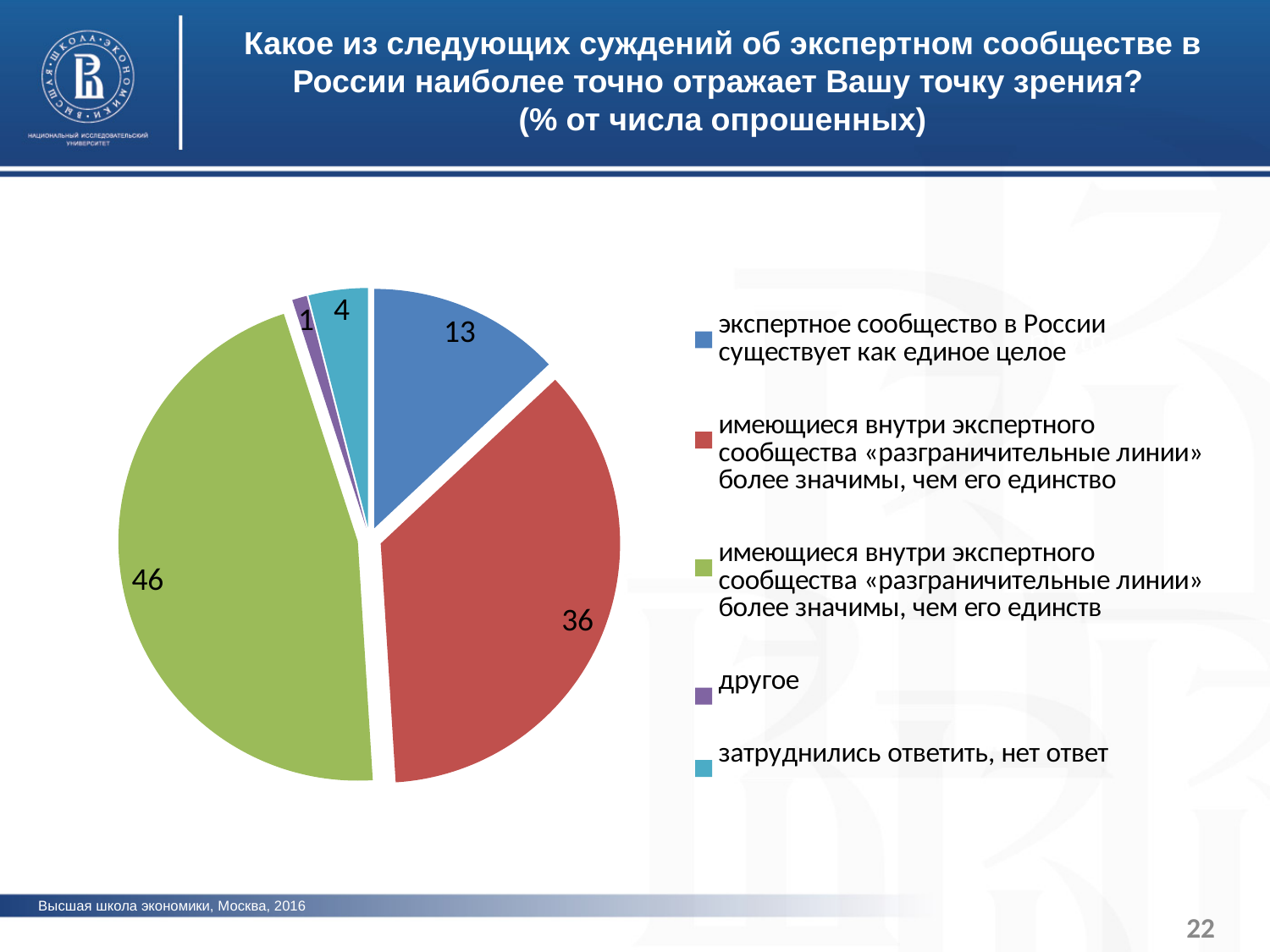
What is the difference between the value for 'экспертное сообщество в России существует как единое целое' and the value for 'затруднились ответить, нет ответ'? 9 What value is shown for the slice 'другое'? 1 What value is shown for the slice 'затруднились ответить, нет ответ'? 4 What value is shown for the slice 'экспертное сообщество в России существует как единое целое'? 13 How many slices does the pie chart have? 5 How many entries does the legend of the pie chart list? 5 Which is larger: the slice for 'экспертное сообщество в России существует как единое целое' or the slice for 'затруднились ответить, нет ответ'? экспертное сообщество в России существует как единое целое What colour is the slice for 'другое' in the pie chart? purple What is the difference between the value of the green slice and the value of the red slice? 10 Which legend category has the smallest slice in the pie chart? другое What type of chart is shown on the slide? pie chart What value is printed on the largest slice of the pie chart? 46